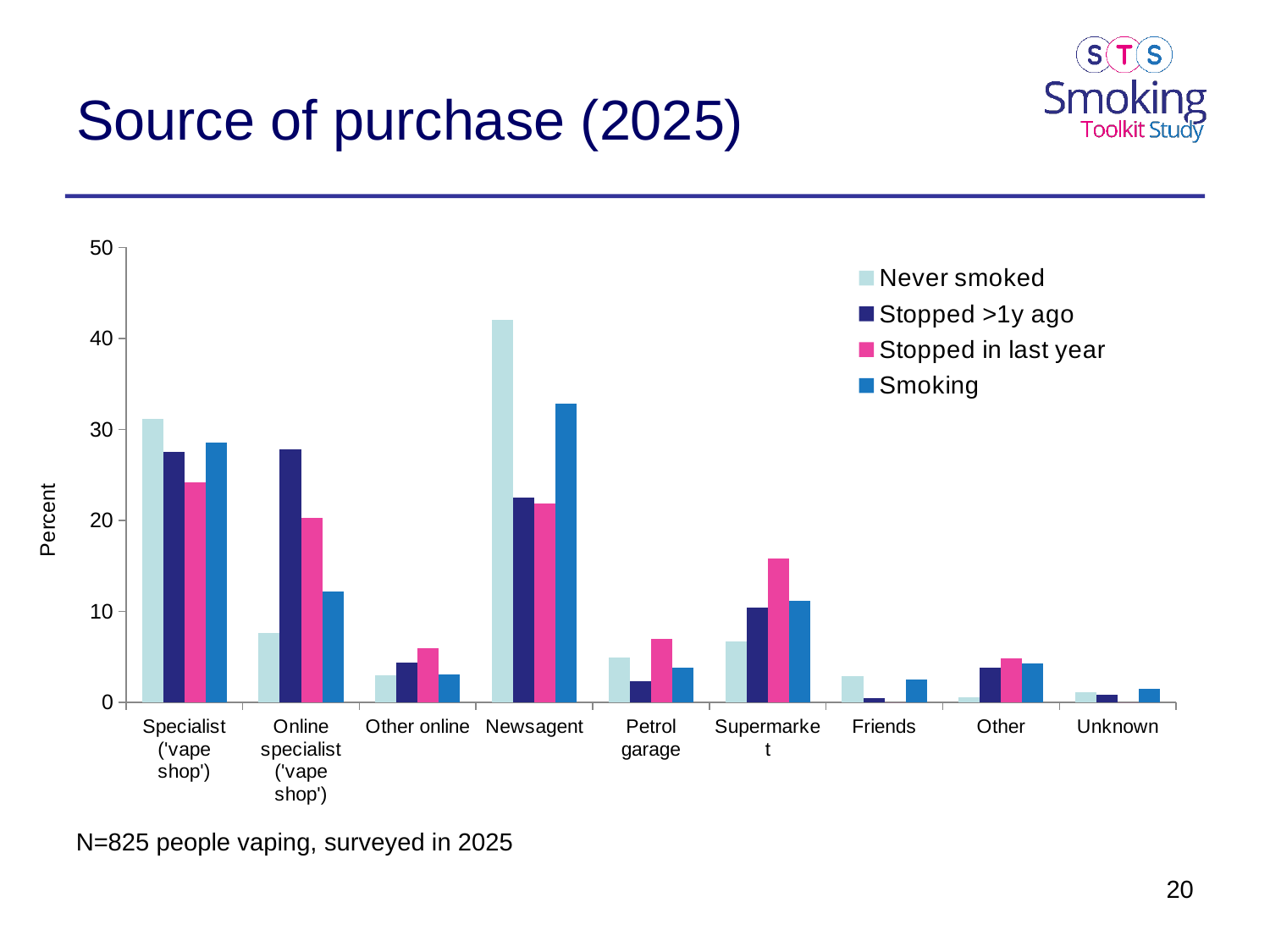
For Online specialist ('vape shop'), which is larger: Stopped >1y ago or Smoking? Stopped >1y ago How many series does the legend list? 4 For Supermarket, which series has the highest value? Stopped in last year How many purchase source categories are shown on the x axis? 9 Is the Never smoked value for Online specialist ('vape shop') greater or less than 10? less Is the Smoking value for Newsagent greater or less than 30? greater What is the title of the chart? Source of purchase (2025) What is the label on the y axis? Percent What kind of chart is shown on the slide? bar chart Is the Never smoked value for Newsagent greater or less than 40? greater For the Never smoked series, which category has the highest value? Newsagent For Specialist ('vape shop'), which is larger: Never smoked or Stopped in last year? Never smoked